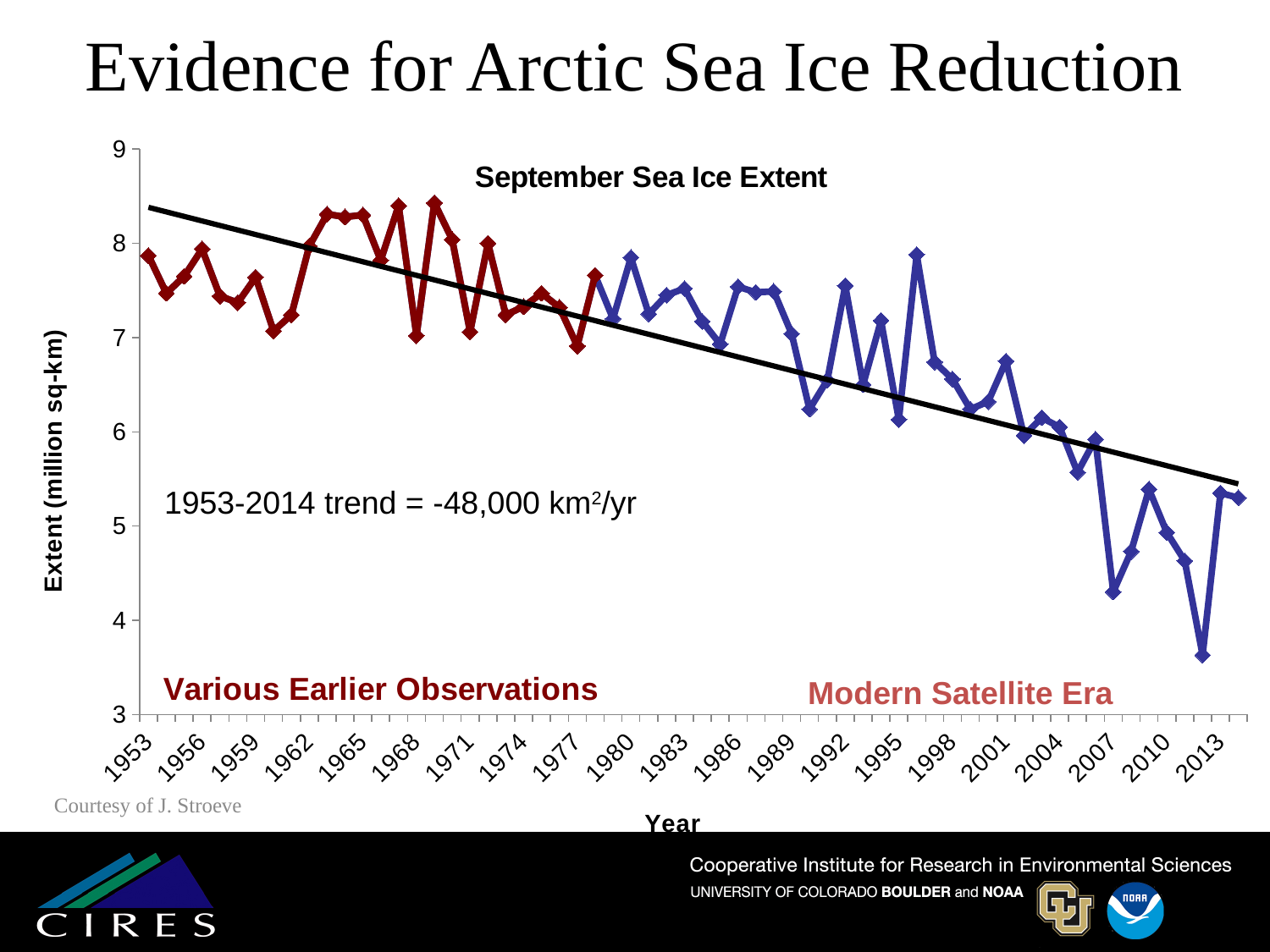
Is the value for 2013 greater or less than 5? greater Is the value for 1996 greater or less than 7? greater Is the value for 2012 greater or less than 4? less What is the title of the chart? September Sea Ice Extent Which year has the larger September sea ice extent, 2007 or 2012? 2007 What kind of chart is shown on the slide? line chart What trend value for 1953-2014 is printed on the chart? -48,000 km²/yr Do the September sea ice extent values generally rise or fall from 1953 to 2014? fall Which year has the larger September sea ice extent, 1953 or 2013? 1953 Which year has the lowest September sea ice extent? 2012